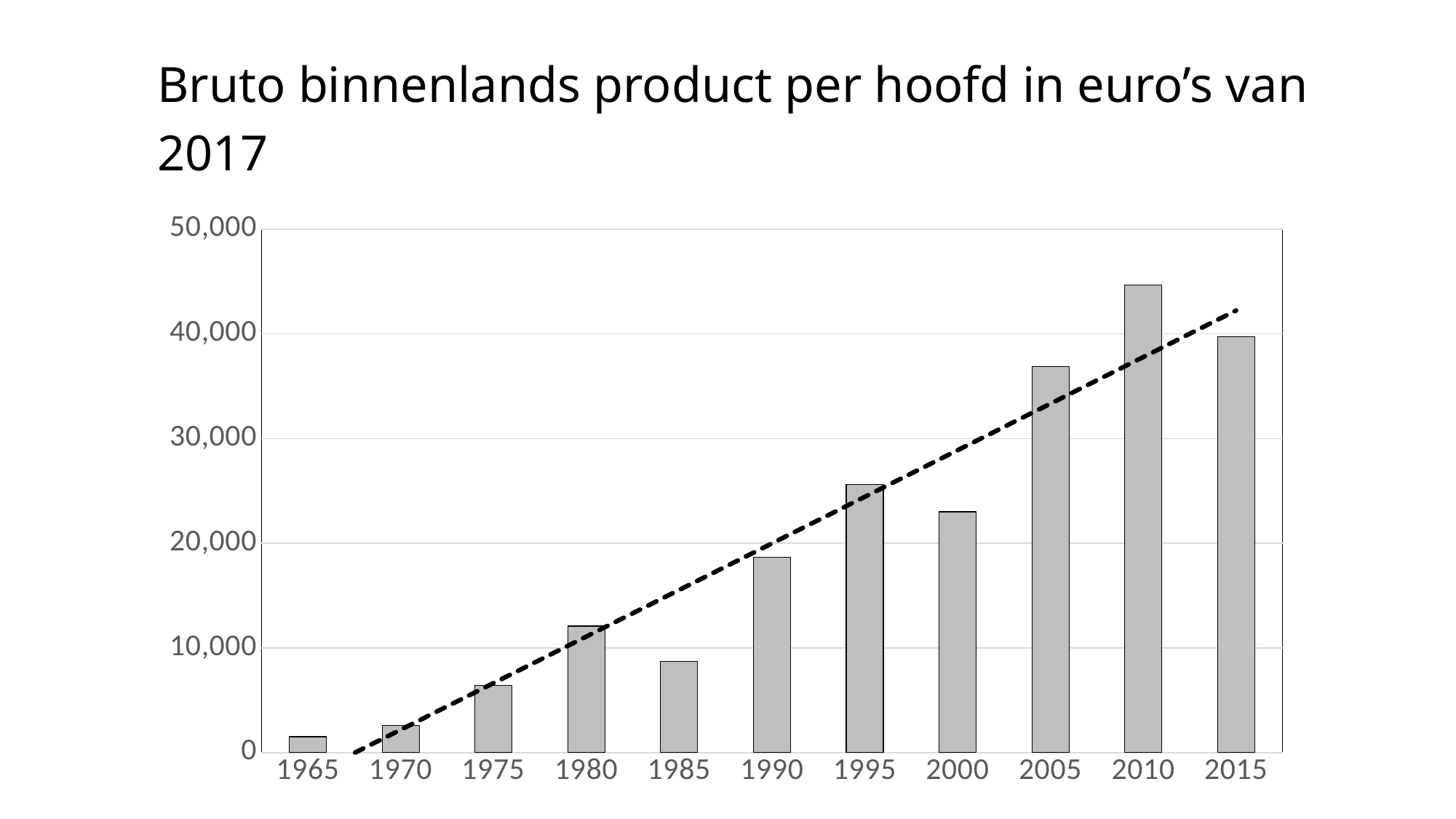
Is the value for 1990 greater or less than 20,000? less Which year has the highest bar in the chart? 2010 Which year has the lowest bar in the chart? 1965 Which year has the larger value, 1980 or 1985? 1980 Is the value for 1985 greater or less than 10,000? less What is the title of the chart on the slide? Bruto binnenlands product per hoofd in euro's van 2017 Do the values generally rise or fall from 1965 to 2015? Rise How many years are shown on the x axis of the chart? 11 Is the value for 2005 greater or less than 30,000? greater Which year has the larger value, 1995 or 2000? 1995 What kind of chart is shown on the slide? Bar chart